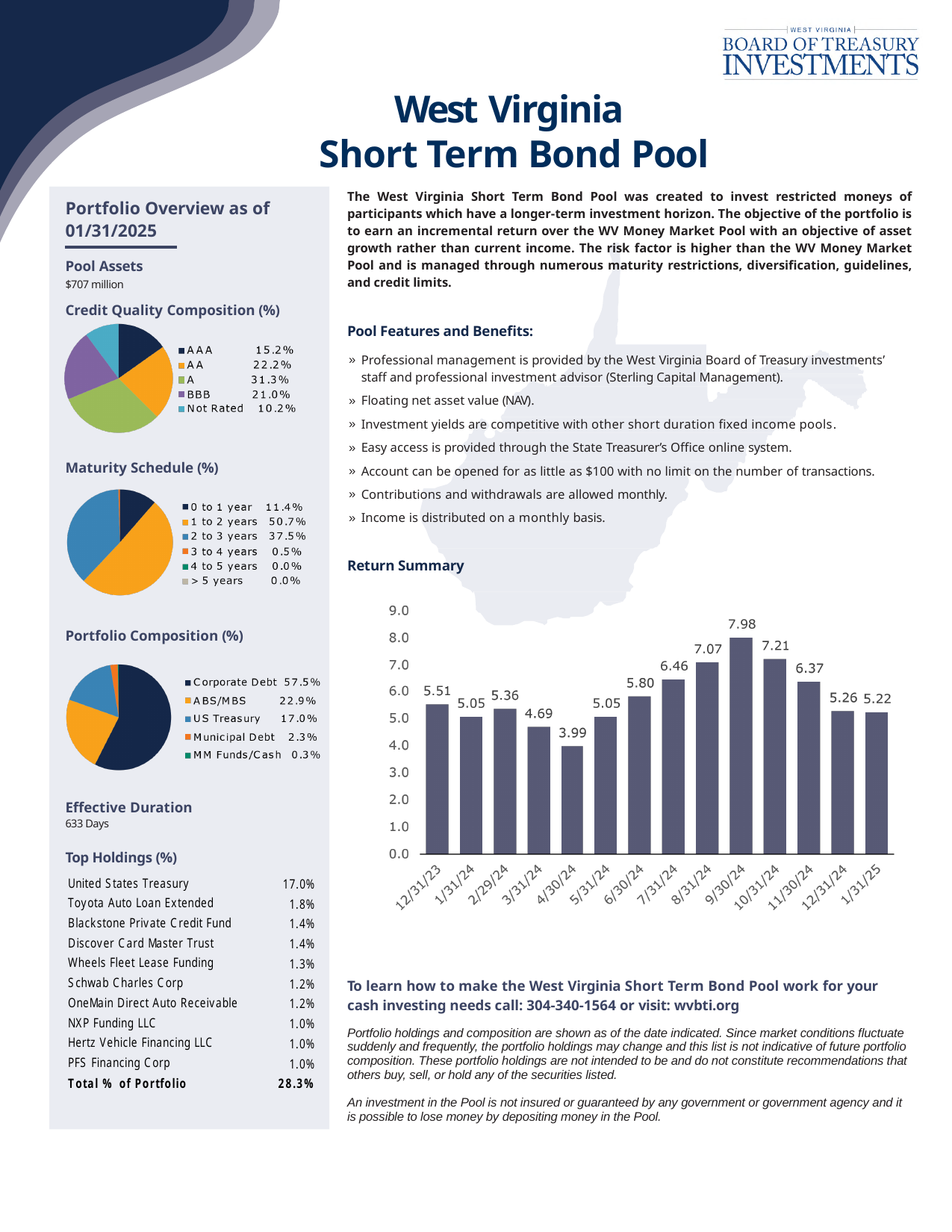
In the Return Summary chart, do the values rise or fall from 4/30/24 to 9/30/24? rise In the Return Summary chart, which is larger, the value for 12/31/23 or the value for 1/31/25? 12/31/23 In the Portfolio Composition pie chart, what share is ABS/MBS? 22.9% In the Credit Quality Composition pie chart, what share is rated A? 31.3% In the Return Summary chart, which date has the lowest value? 4/30/24 In the Return Summary chart, what is the value for 9/30/24? 7.98 In the Maturity Schedule pie chart, which maturity bucket has the largest share? 1 to 2 years What kind of chart is the Return Summary chart? bar chart How many categories does the legend of the Portfolio Composition pie chart list? 5 How many bars are plotted in the Return Summary chart? 14 In the Return Summary chart, what is the difference between the values for 9/30/24 and 4/30/24? 3.99 In the Return Summary chart, which date has the highest value? 9/30/24